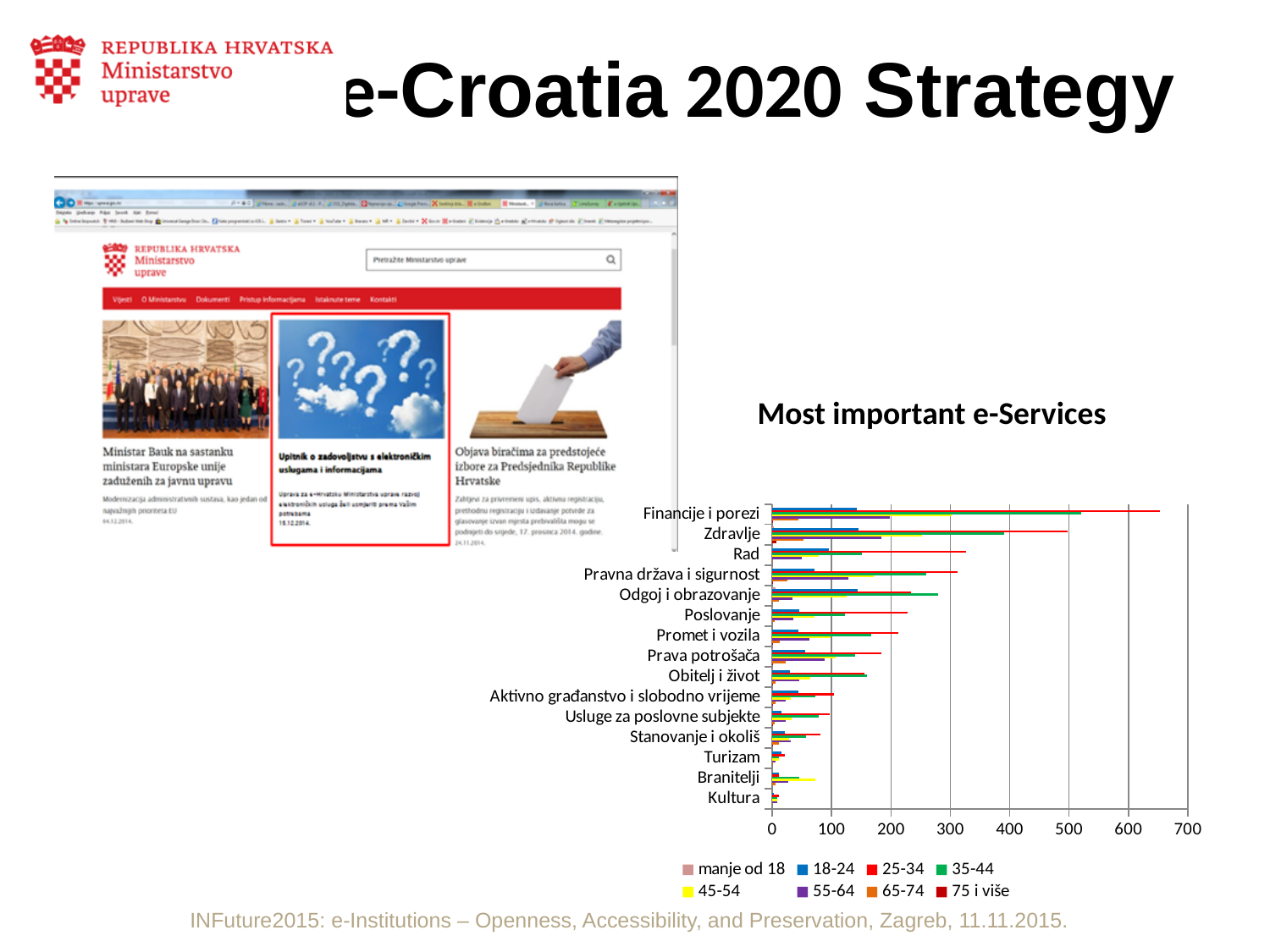
What is the title of the chart? Most important e-Services Which category has the longest bar for the 25-34 series? Financije i porezi Is the value of the 25-34 series for Zdravlje greater or less than 400? greater Which category has the smallest values across all series? Kultura Which is larger for the 25-34 series: Financije i porezi or Zdravlje? Financije i porezi What colour represents the 25-34 series in the legend? red Is the value of the 25-34 series for Financije i porezi greater or less than 600? greater What kind of chart is shown on the slide? bar chart How many categories are listed on the chart's vertical axis? 15 Is the value of the 35-44 series for Financije i porezi greater or less than 500? greater How many series does the chart's legend list? 8